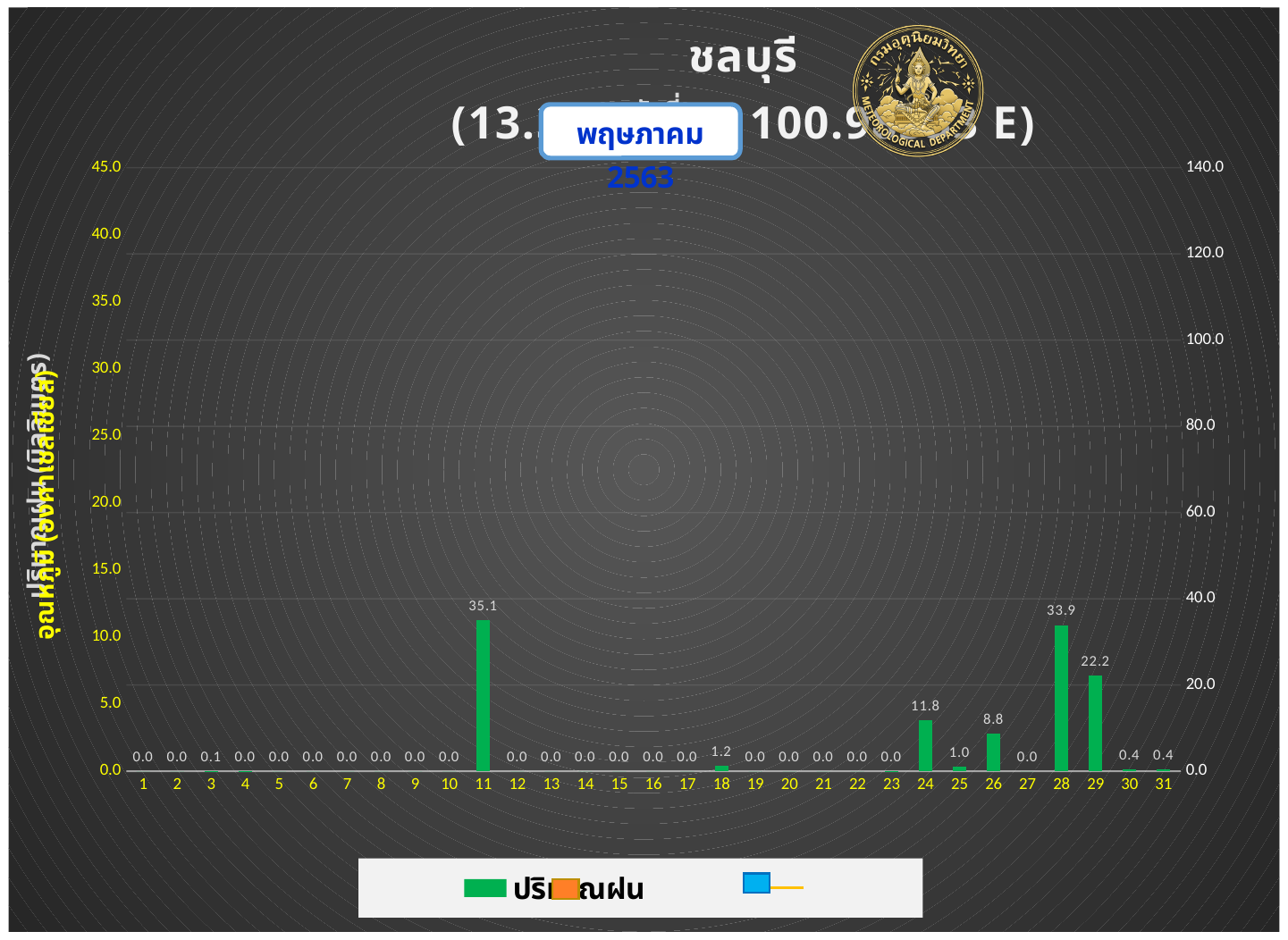
What is the value for day 11? 35.1 What is the value for day 28? 33.9 What is the value for day 26? 8.8 What is the value for day 18? 1.2 What is the difference between the values for day 11 and day 28? 1.2 Which day has the highest value? 11 What is the difference between the values for day 28 and day 29? 11.7 What kind of chart is this? bar chart What is the value for day 24? 11.8 Which is larger, the value for day 24 or the value for day 26? day 24 What is the value for day 29? 22.2 How many days are shown on the x axis? 31